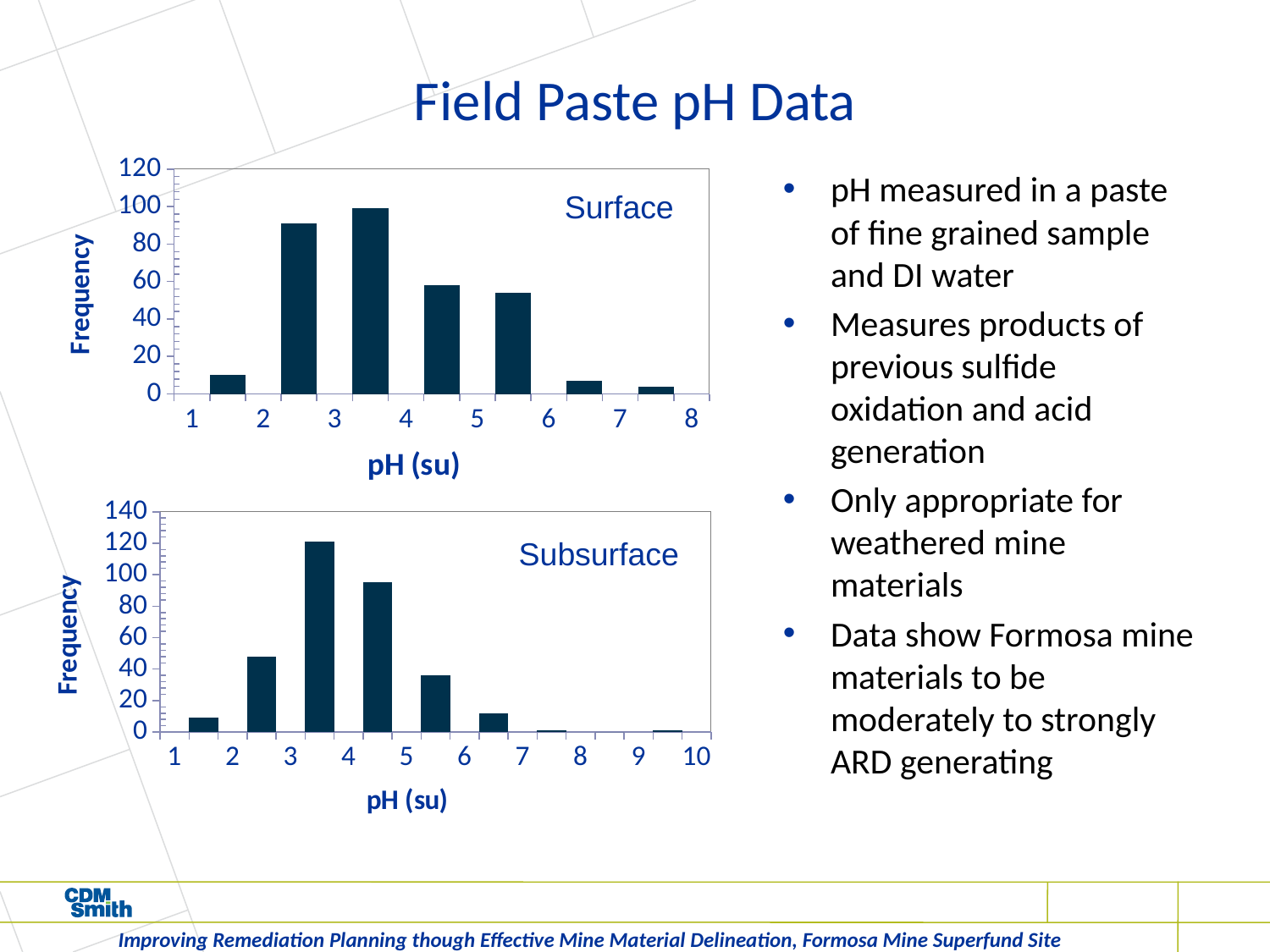
In the Surface chart, which bar is taller: the one between pH 2 and 3 or the one between pH 4 and 5? between pH 2 and 3 In the Subsurface chart, which bar is taller: the one between pH 3 and 4 or the one between pH 4 and 5? between pH 3 and 4 In the Subsurface chart, is the frequency of the bar between pH 3 and 4 greater or less than 100? greater What kind of chart is the Surface chart? bar chart What is the label on the x axis of the Subsurface chart? pH (su) In the Surface chart, between which two pH values does the tallest bar lie? 3 and 4 In the Surface chart, is the frequency of the bar between pH 4 and 5 greater or less than 40? greater In the Subsurface chart, between which two pH values does the tallest bar lie? 3 and 4 In the Surface chart, is the frequency of the bar between pH 2 and 3 greater or less than 80? greater What is the label on the y axis of the Surface chart? Frequency